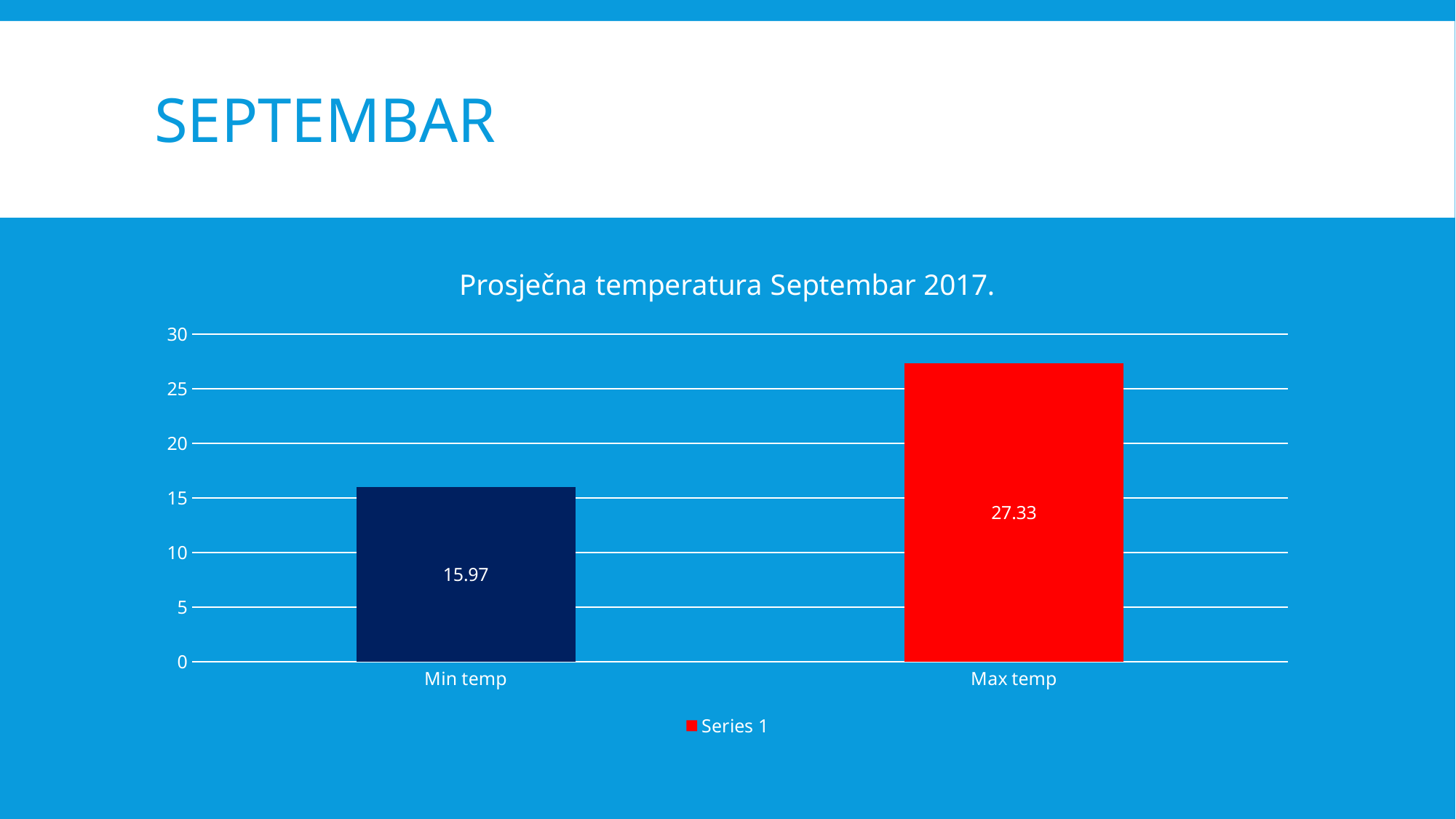
What is the value for Min temp? 15.97 Which category has the highest value? Max temp How many categories are shown on the x axis? 2 How many series does the legend list? 1 What is the value for Max temp? 27.33 What is the difference between the Max temp and Min temp values? 11.36 Is the value for Min temp greater or less than 20? less What kind of chart is shown on the slide? bar chart Which is larger, the value for Min temp or the value for Max temp? Max temp What is the title of the chart? Prosječna temperatura Septembar 2017. Is the value for Max temp greater or less than 25? greater Which category has the lowest value? Min temp